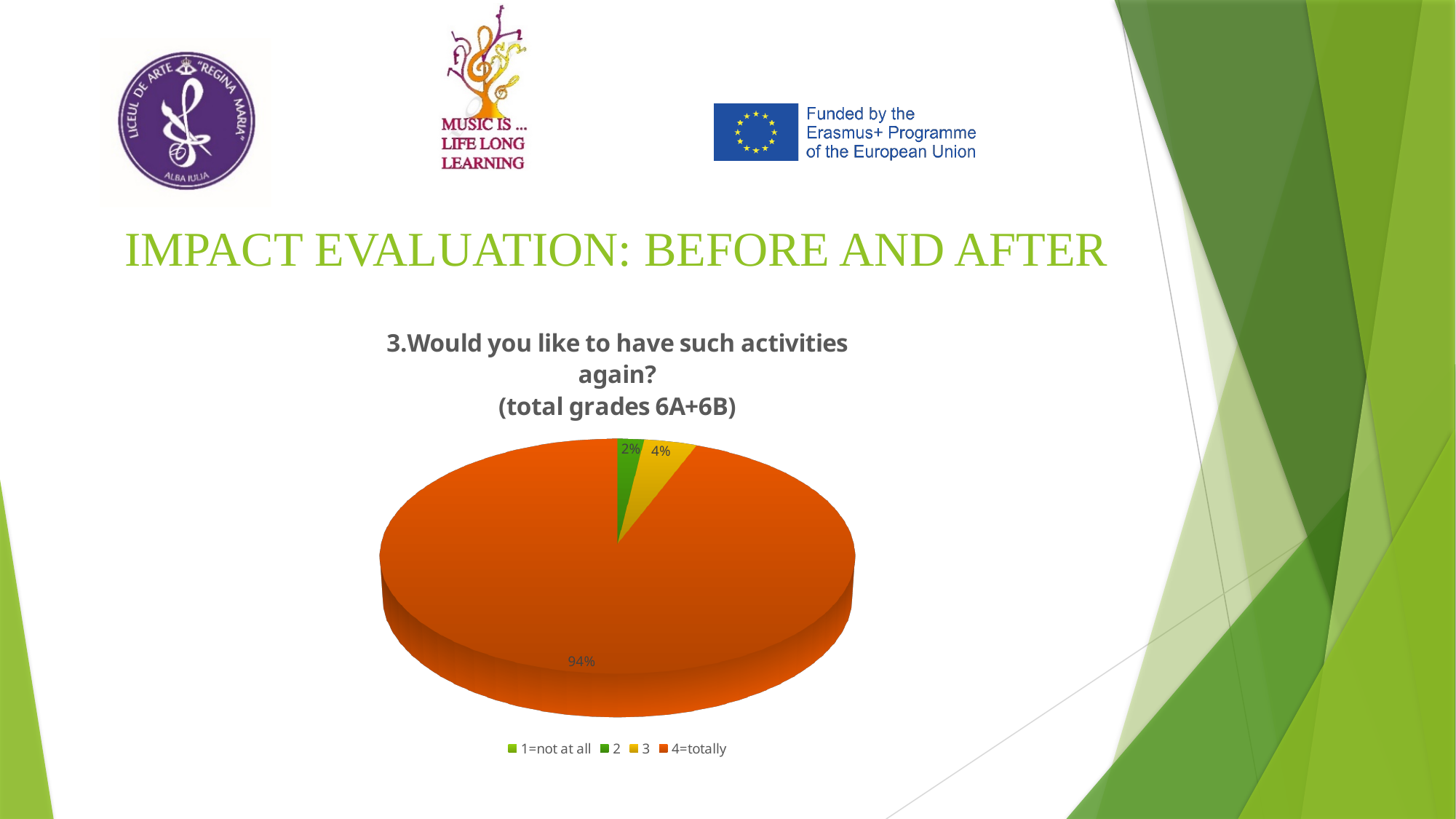
Which category has the largest slice of the pie? 4=totally What share of the pie is labelled for the category "3"? 4% What share of the pie is labelled for the category "2"? 2% What is the difference in percentage points between the "4=totally" slice and the "3" slice? 90 What is the combined share of the "2" and "3" slices? 6% Which is larger, the slice for "3" or the slice for "2"? 3 What colour is the slice for "4=totally"? orange What kind of chart is shown on the slide? pie chart How many entries does the chart legend list? 4 Which of the labelled slices is the smallest? 2 What share of the pie is labelled for the category "4=totally"? 94% What is the title of the chart? 3.Would you like to have such activities again? (total grades 6A+6B)